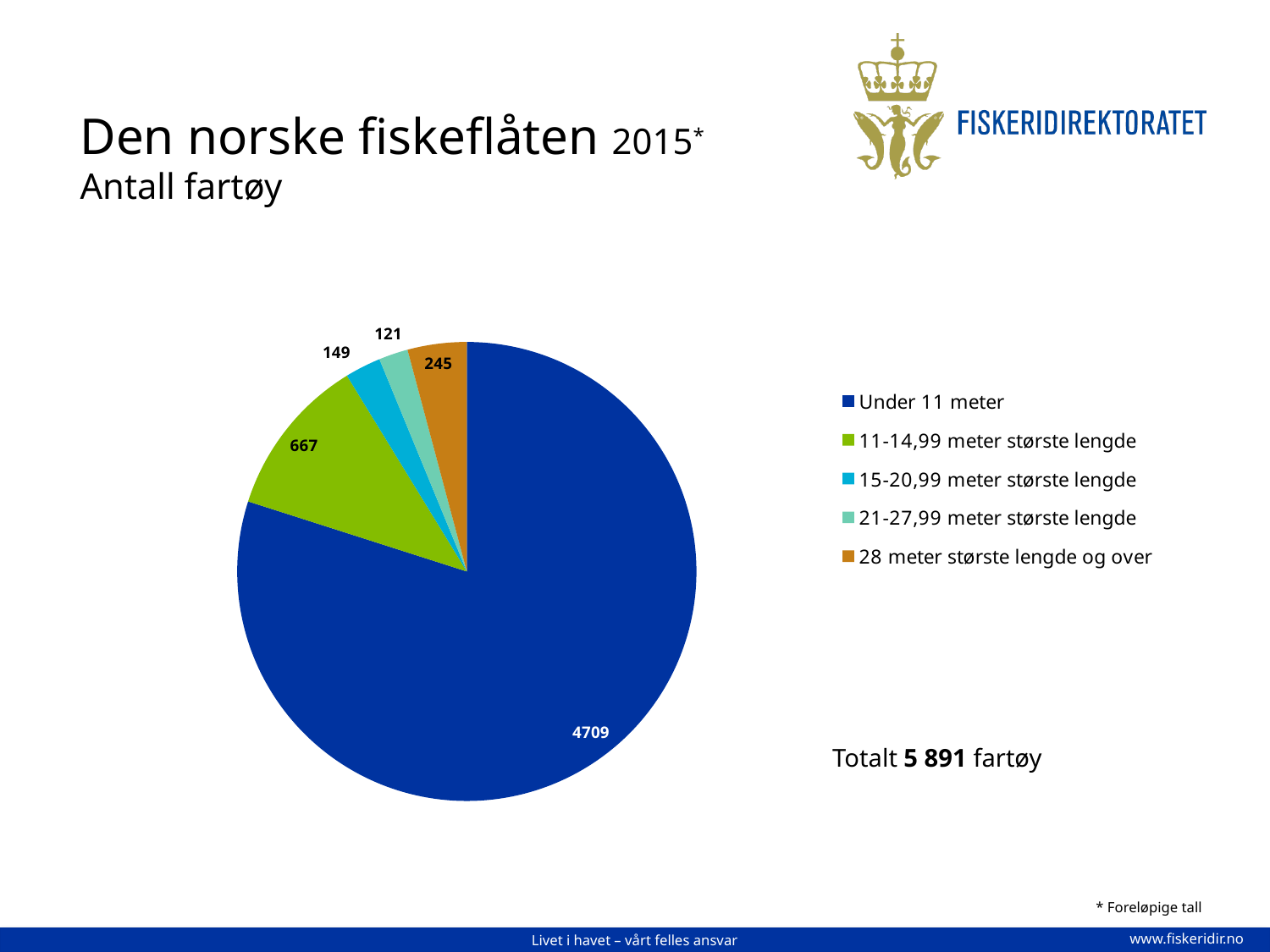
What total number of vessels is stated on the slide? 5 891 What is the value for '15-20,99 meter største lengde'? 149 Which category has the smallest slice of the pie? 21-27,99 meter største lengde What is the value for '11-14,99 meter største lengde'? 667 What is the value for '21-27,99 meter største lengde'? 121 How many categories does the pie chart have? 5 What type of chart is shown on the slide? Pie chart What is the difference between the 'Under 11 meter' value and the '11-14,99 meter største lengde' value? 4042 What is the value for '28 meter største lengde og over'? 245 How many vessels are in the 'Under 11 meter' category? 4709 Which category has the largest slice of the pie? Under 11 meter Which is larger: the value for '28 meter største lengde og over' or the value for '15-20,99 meter største lengde'? 28 meter største lengde og over